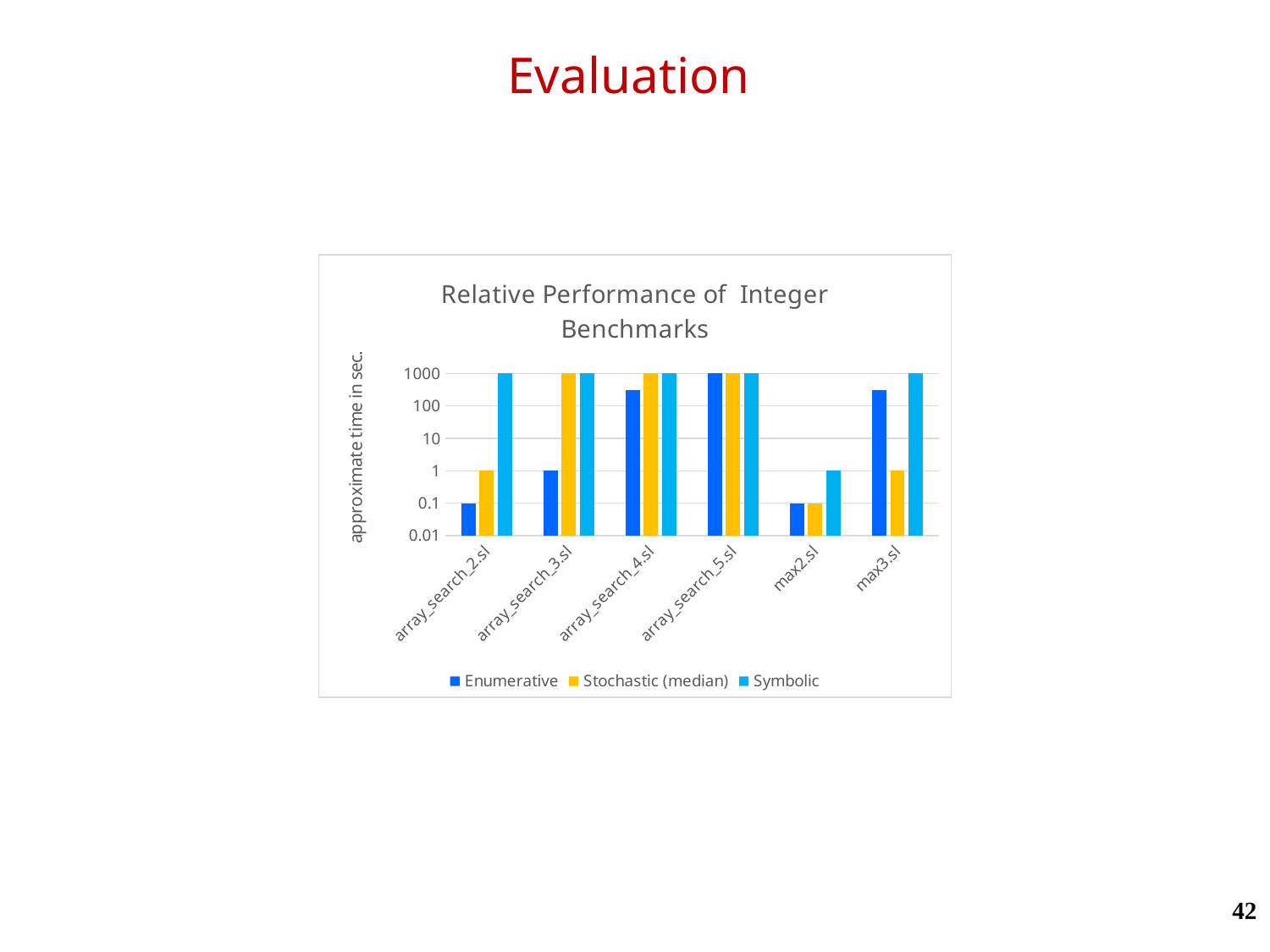
What is the Enumerative value for array_search_2.sl? 0.1 What is the title of the chart? Relative Performance of Integer Benchmarks How many series does the legend list? 3 What is the y-axis label of the chart? approximate time in sec. Is the Enumerative value for array_search_4.sl greater or less than 100? greater For array_search_3.sl, which is larger: the Enumerative value or the Stochastic (median) value? Stochastic (median) What is the Symbolic value for max2.sl? 1 For max2.sl, which series has the highest value? Symbolic What is the Symbolic value for array_search_2.sl? 1000 What type of chart is shown on the slide? bar chart How many benchmark categories are shown on the x axis? 6 Is the Enumerative value for max3.sl greater or less than 1000? less